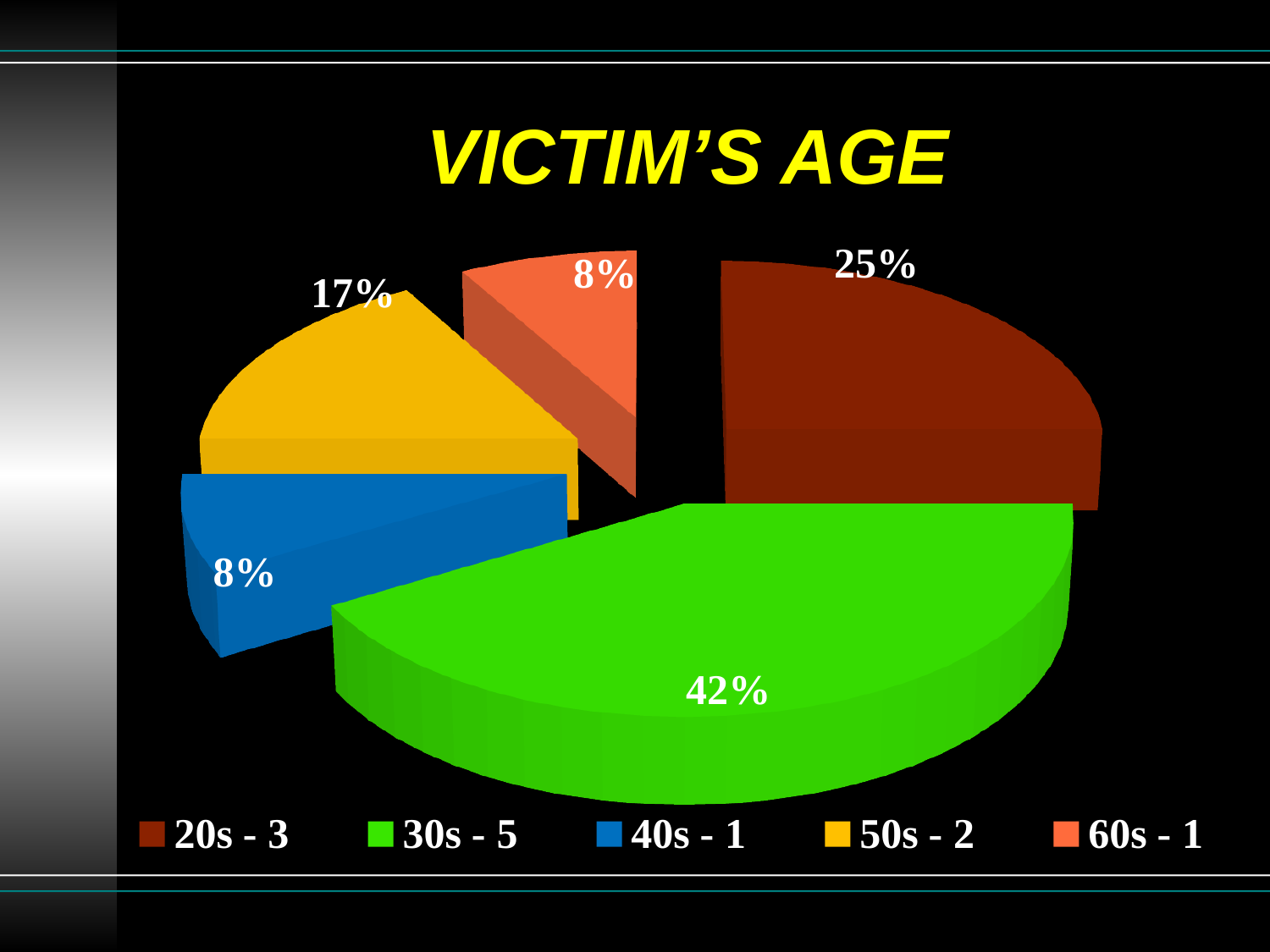
What percentage of the pie does the 30s - 5 slice represent? 42% What is the title of the chart? VICTIM'S AGE What colour is the slice for 40s - 1? Blue What is the difference in percentage points between the 30s - 5 slice and the 20s - 3 slice? 17% How many entries does the legend list? 5 What percentage of the pie does the 50s - 2 slice represent? 17% What type of chart is shown on the slide? Pie chart Which is larger, the share for 20s - 3 or the share for 50s - 2? 20s - 3 What percentage of the pie does the 40s - 1 slice represent? 8% How many slices does the pie chart have? 5 Which age group has the largest slice of the pie? 30s - 5